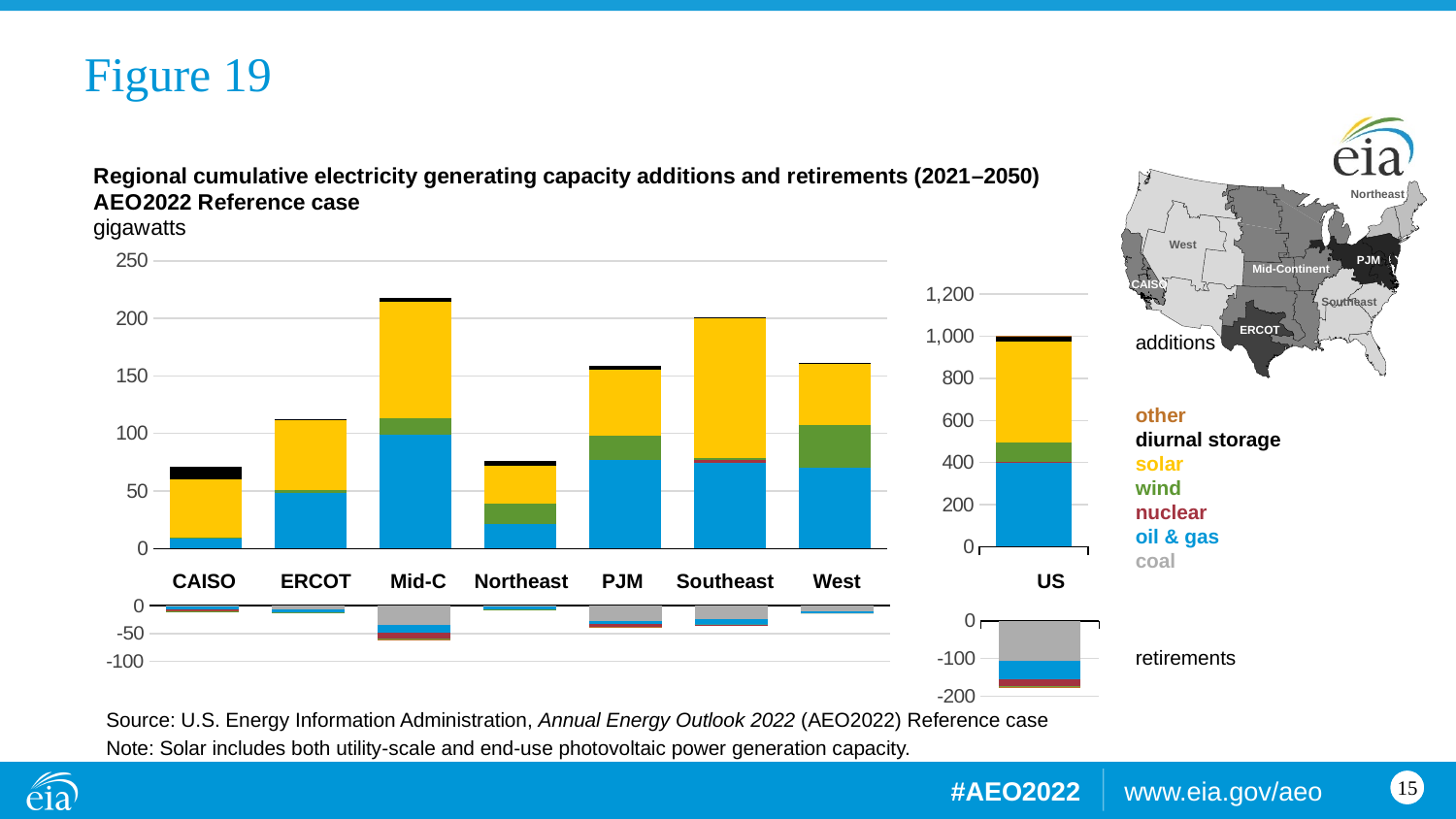
In the Southeast additions bar, which series accounts for the largest portion? solar In the regional additions chart, which has larger total additions, Southeast or PJM? Southeast What kind of chart is used to show regional cumulative electricity generating capacity additions and retirements? stacked bar chart In the regional additions chart, is the total additions value for CAISO greater or less than 100 gigawatts? less How many regions are shown on the x axis of the regional additions chart (excluding the separate US bar)? 7 In the regional retirements chart, which region has the largest cumulative retirements? Mid-C In the regional additions chart, which region has the highest cumulative capacity additions? Mid-C In the regional additions chart, is the total additions value for Mid-C greater or less than 200 gigawatts? greater How many series does the legend list? 7 In the regional additions chart, is the total additions value for ERCOT greater or less than 100 gigawatts? greater What unit is used on the y axis of the charts? gigawatts